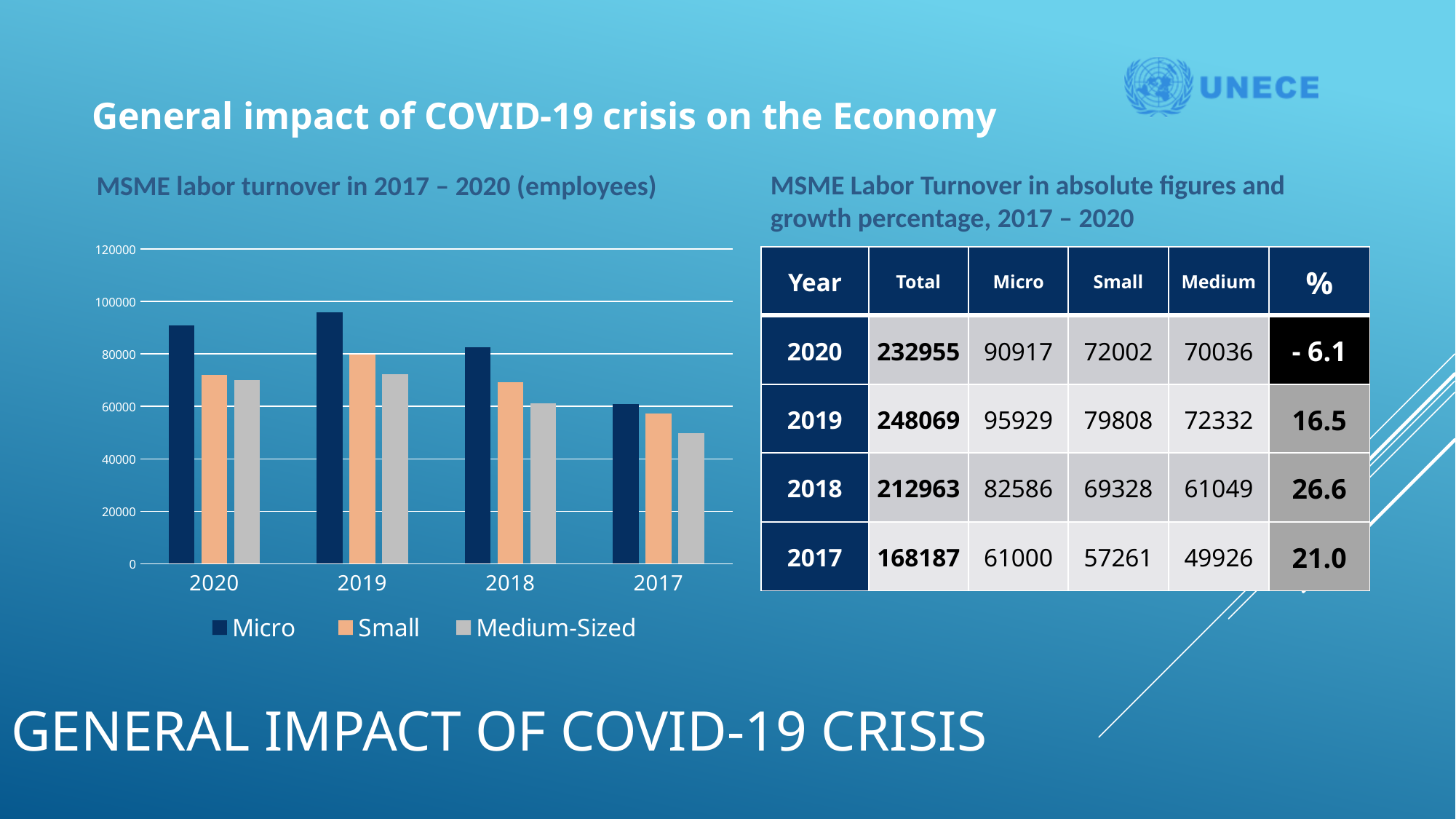
In the bar chart, do the Small bars rise or fall going from 2019 to 2017 along the x axis? fall In the bar chart, is the Micro value for 2019 greater or less than 80000? greater According to the slide, what is the Small labor turnover for 2017? 57261 How many series does the legend of the bar chart list? 3 In the bar chart, which is larger for 2020: Micro or Small? Micro What kind of chart is shown under the title "MSME labor turnover in 2017 – 2020 (employees)"? bar chart How many years are shown on the x axis of the bar chart? 4 In the bar chart, is the Medium-Sized value for 2017 greater or less than 60000? less According to the slide, what is the Micro labor turnover for 2020? 90917 What colour are the Micro bars in the bar chart? dark blue In the bar chart, which year has the highest Micro bar? 2019 In the bar chart, which year has the lowest Medium-Sized bar? 2017